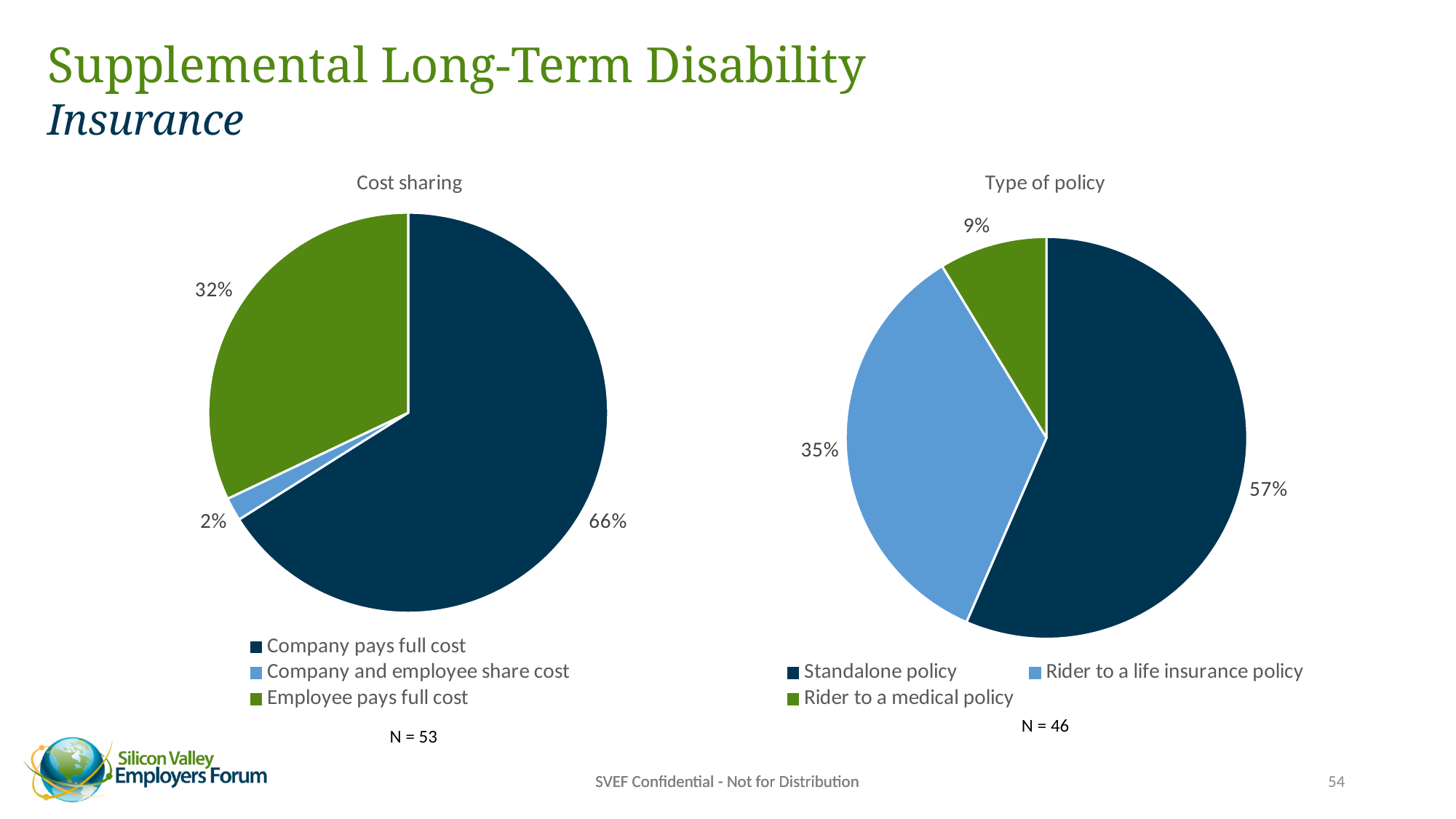
In the 'Type of policy' chart, which category has the smallest slice? Rider to a medical policy In the 'Cost sharing' chart, which category has the largest slice? Company pays full cost In the 'Cost sharing' chart, what share of the pie is 'Employee pays full cost'? 32% In the 'Type of policy' chart, what share of the pie is 'Standalone policy'? 57% What kind of chart is the 'Type of policy' chart? Pie chart In the 'Cost sharing' chart, what share of the pie is 'Company and employee share cost'? 2% In the 'Cost sharing' chart, which category has the smallest slice? Company and employee share cost In the 'Cost sharing' chart, what is the difference between 'Company pays full cost' and 'Employee pays full cost'? 34% In the 'Type of policy' chart, which is larger: 'Standalone policy' or 'Rider to a life insurance policy'? Standalone policy